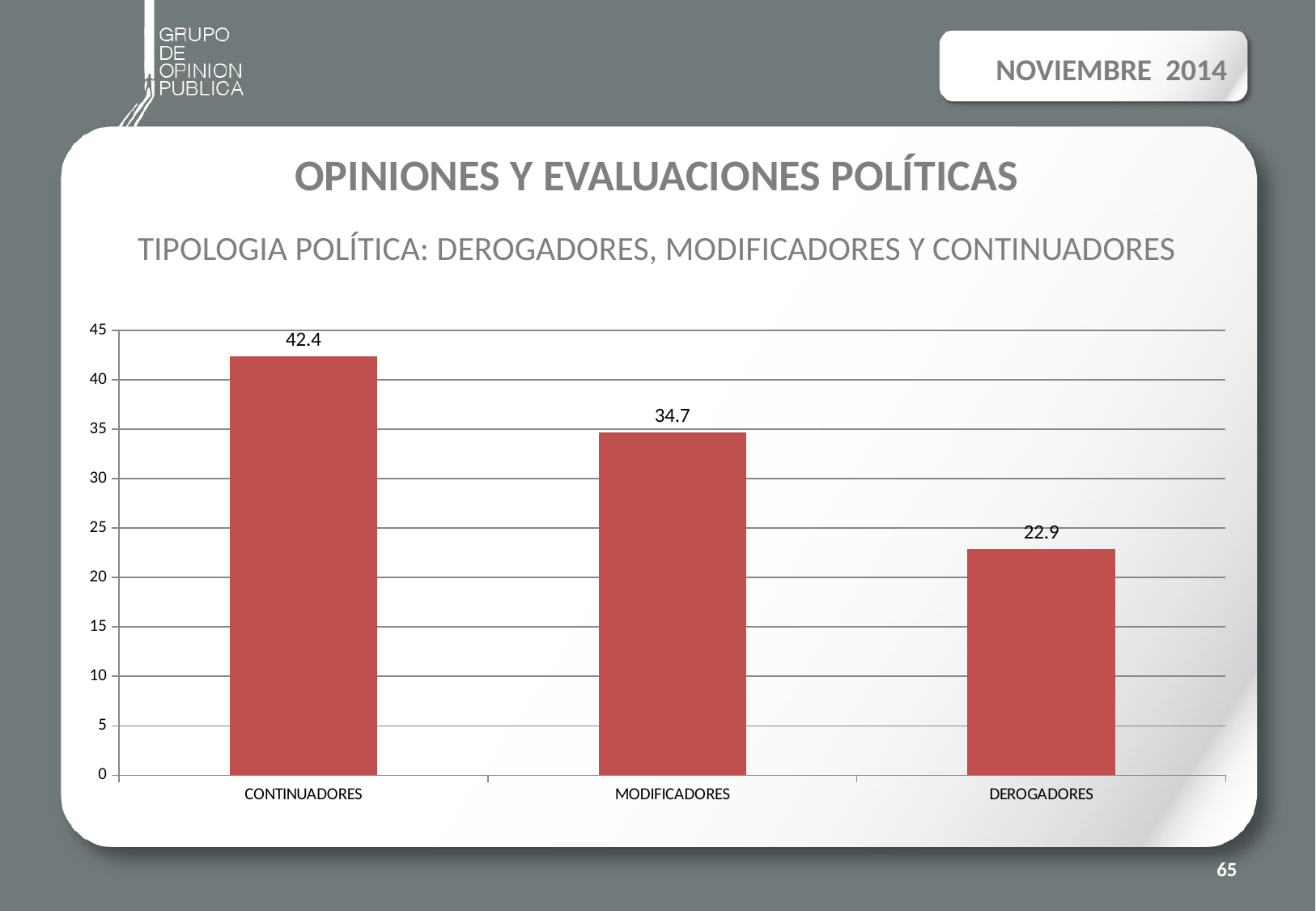
What kind of chart is shown on the slide? bar chart Is the value for MODIFICADORES greater or less than 30? greater Which category has the lowest value? DEROGADORES What is the value for MODIFICADORES? 34.7 Which category has the highest value? CONTINUADORES How many categories are shown on the x axis? 3 Which is larger, the value for MODIFICADORES or the value for DEROGADORES? MODIFICADORES What is the difference between the values for CONTINUADORES and DEROGADORES? 19.5 What is the value for CONTINUADORES? 42.4 Do the values rise or fall from left to right along the x axis? fall What is the difference between the values for MODIFICADORES and DEROGADORES? 11.8 What is the value for DEROGADORES? 22.9